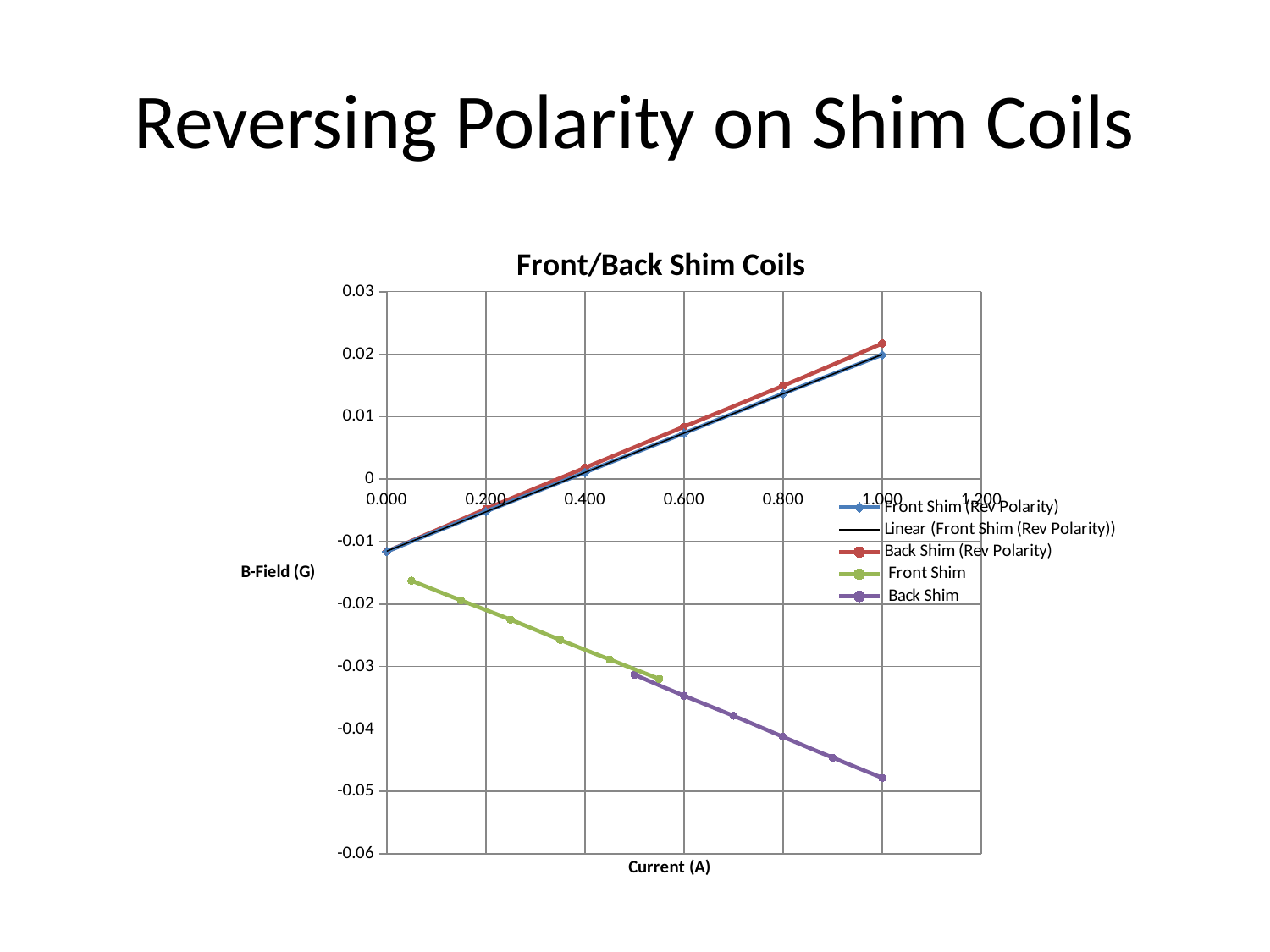
Is the Back Shim value at 1.000 A greater or less than -0.04? less Is the Front Shim (Rev Polarity) value at 1.000 A greater or less than 0.01? greater What is the title of the chart? Front/Back Shim Coils Does the Front Shim (Rev Polarity) series rise or fall as current increases? Rises What is the label of the vertical axis? B-Field (G) Does the Front Shim series rise or fall as current increases? Falls At 1.000 A, which series has the larger B-field value: Front Shim (Rev Polarity) or Back Shim? Front Shim (Rev Polarity) What kind of chart is shown on the slide? Line chart Does the Back Shim series rise or fall as current increases? Falls How many series does the legend of the Front/Back Shim Coils chart list? 5 Is the Back Shim (Rev Polarity) value at 0.800 A greater or less than 0.01? greater